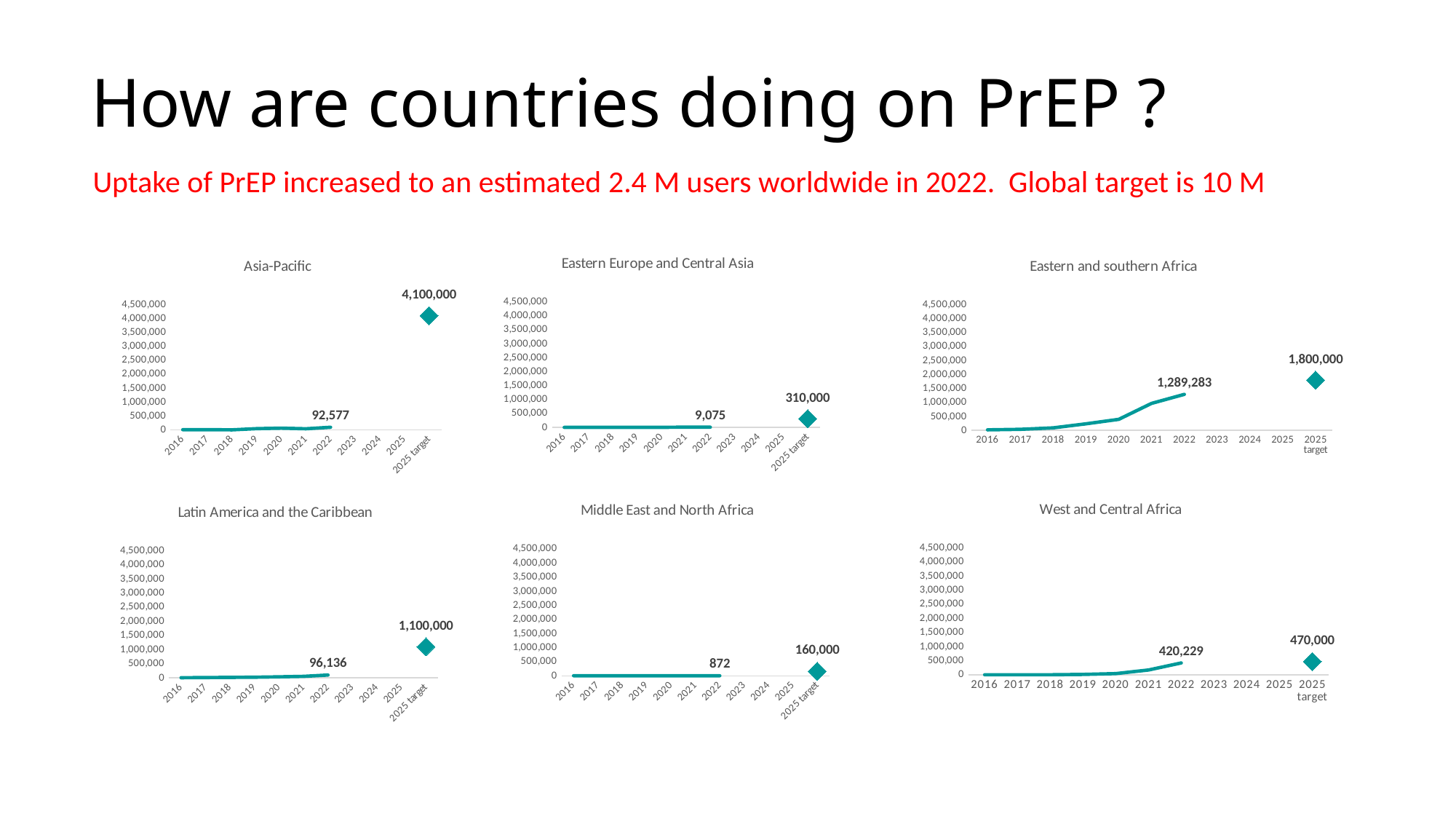
In the Eastern and southern Africa chart, what is the difference between the 2025 target and the 2022 value? 510,717 In the Middle East and North Africa chart, what is the 2025 target value? 160,000 What type of chart is used for the Asia-Pacific data? line chart In the Latin America and the Caribbean chart, which is larger, the 2022 value or the 2025 target? 2025 target In the Eastern Europe and Central Asia chart, what is the labelled value for 2022? 9,075 In the Asia-Pacific chart, what is the labelled value for 2022? 92,577 Which of the six regional charts shows the lowest labelled 2022 value? Middle East and North Africa In the Eastern and southern Africa chart, does the line rise or fall from 2016 to 2022? rise In the West and Central Africa chart, what is the labelled value for 2022? 420,229 In the Asia-Pacific chart, what is the 2025 target value? 4,100,000 Which of the six regional charts shows the highest 2025 target? Asia-Pacific In the Eastern and southern Africa chart, what is the labelled value for 2022? 1,289,283